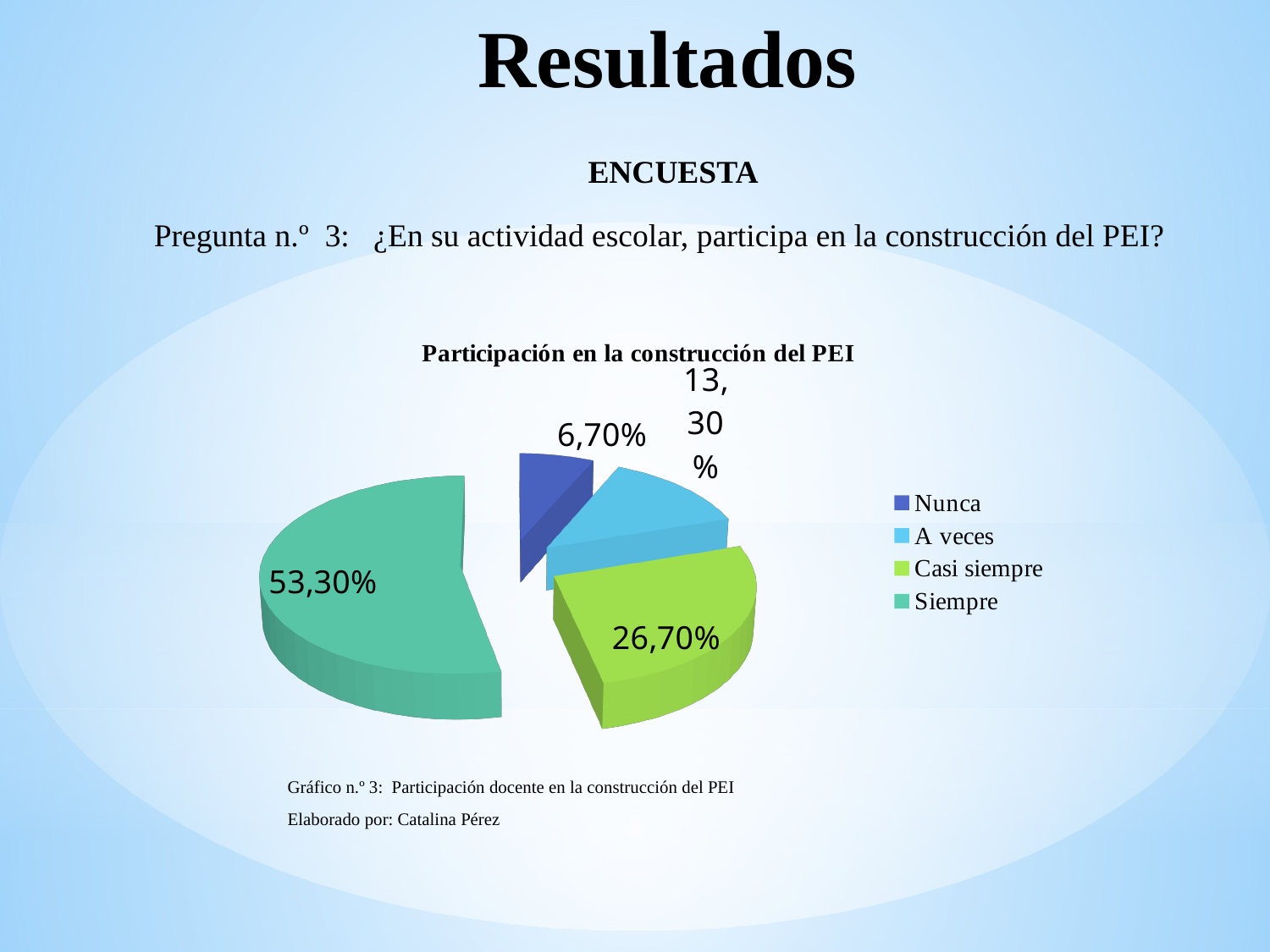
Which category has the largest slice of the pie? Siempre What colour is the slice for Siempre? teal green Which is larger, the slice for A veces or the slice for Casi siempre? Casi siempre How many categories does the legend list? 4 What percentage of the pie corresponds to Nunca? 6,70% What type of chart is shown on the slide? pie chart What percentage of the pie corresponds to Siempre? 53,30% What percentage of the pie corresponds to Casi siempre? 26,70% Which category has the smallest slice of the pie? Nunca What is the difference in percentage points between Siempre and Casi siempre? 26,60 What percentage of the pie corresponds to A veces? 13,30% What is the chart's title? Participación en la construcción del PEI